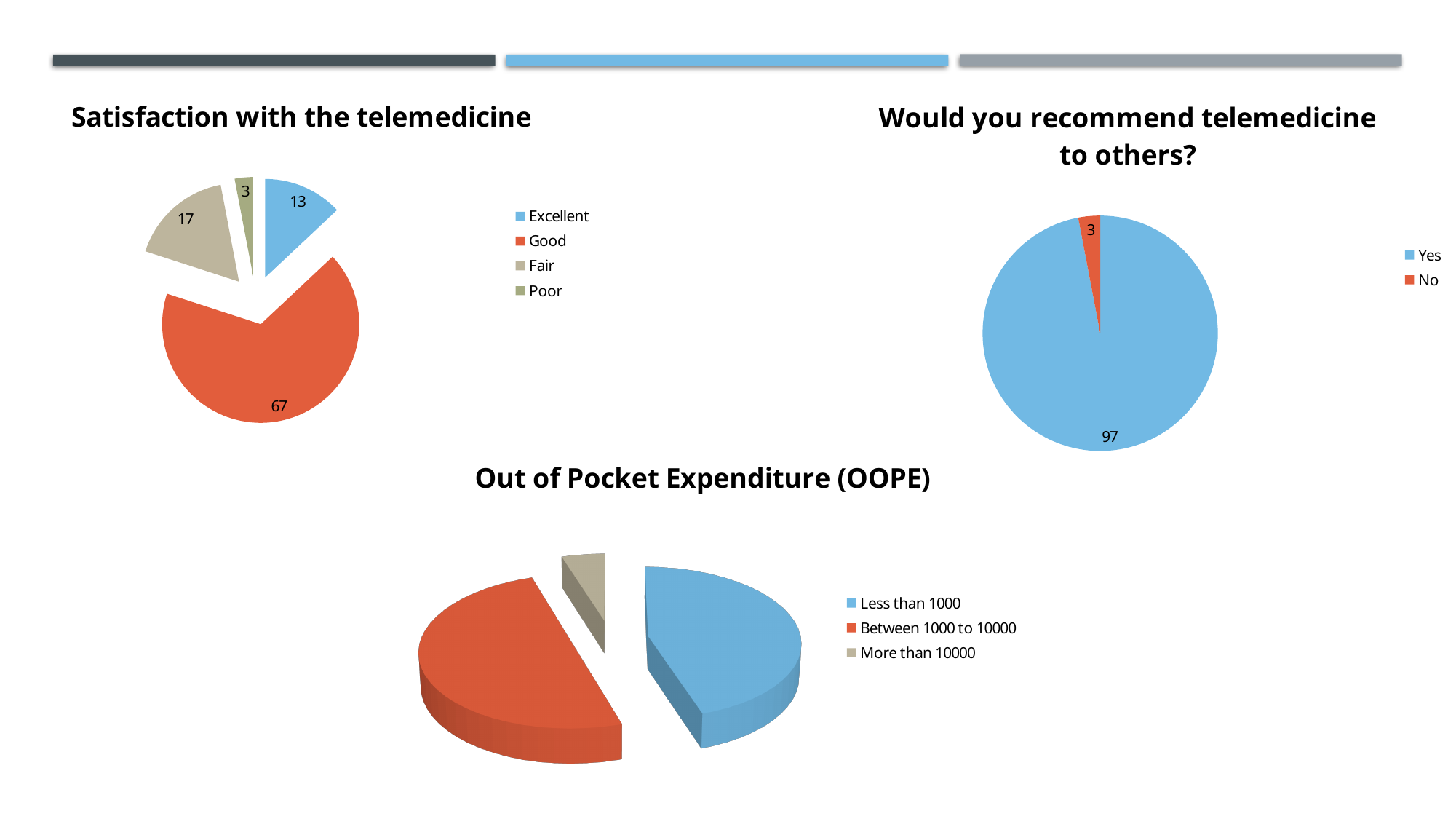
In the 'Satisfaction with the telemedicine' chart, which category has the largest slice? Good In the 'Satisfaction with the telemedicine' chart, what is the value for Good? 67 In the 'Would you recommend telemedicine to others?' chart, what is the value for Yes? 97 What kind of chart is the 'Out of Pocket Expenditure (OOPE)' chart? Pie chart In the 'Out of Pocket Expenditure (OOPE)' chart, which category has the smallest slice? More than 10000 In the 'Out of Pocket Expenditure (OOPE)' chart, how many categories does the legend list? 3 In the 'Satisfaction with the telemedicine' chart, how many categories does the legend list? 4 In the 'Would you recommend telemedicine to others?' chart, which is larger, Yes or No? Yes In the 'Satisfaction with the telemedicine' chart, which category has the smallest slice? Poor In the 'Satisfaction with the telemedicine' chart, what is the difference between the values for Good and Excellent? 54 In the 'Satisfaction with the telemedicine' chart, what is the value for Fair? 17 In the 'Would you recommend telemedicine to others?' chart, what is the value for No? 3